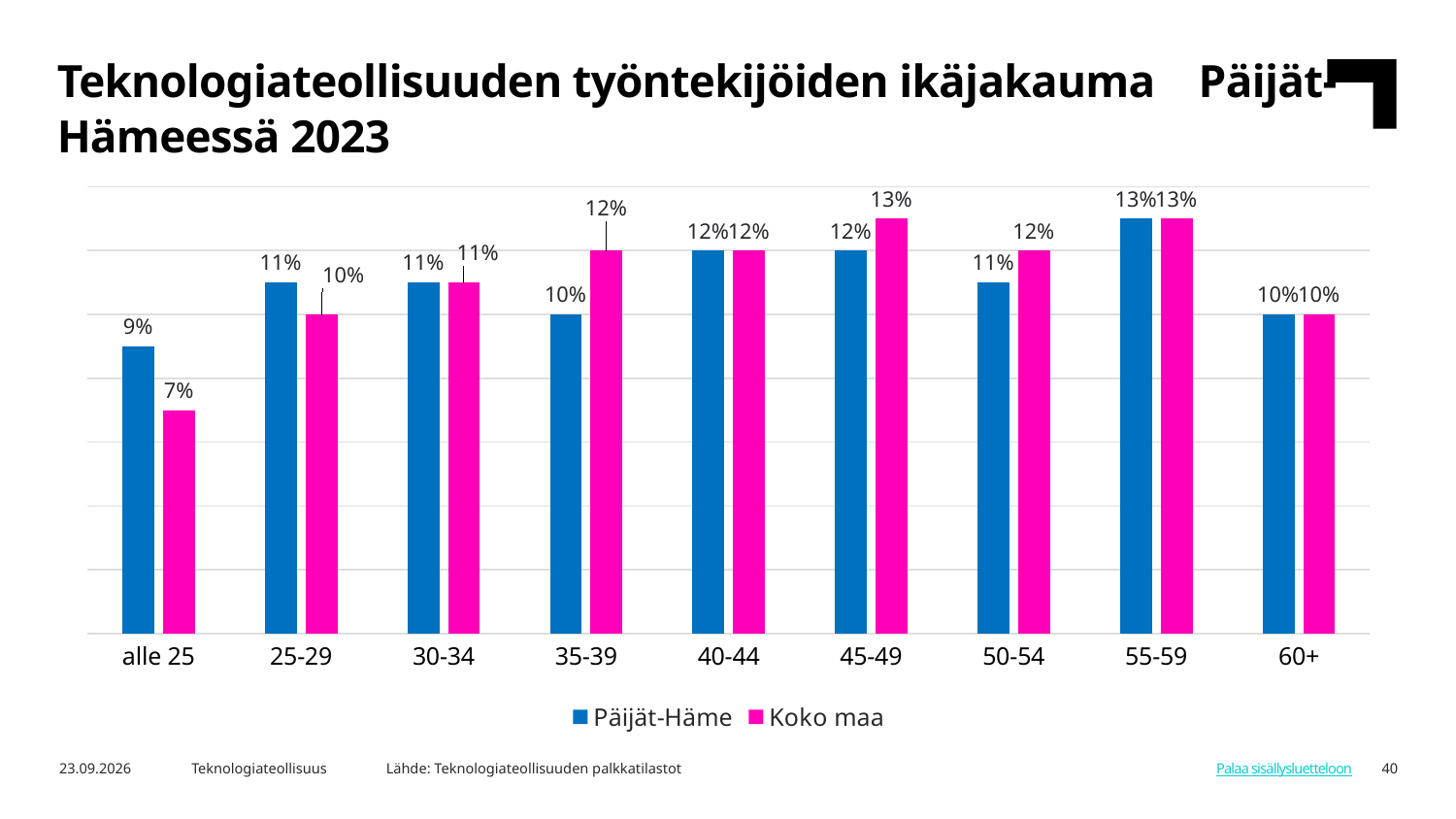
Which series is shown in pink in the legend? Koko maa Which age category has the lowest value for Koko maa? alle 25 What is the value for Koko maa in the 'alle 25' category? 7% How many age categories are shown on the x axis? 9 What is the value for Koko maa in the 35-39 category? 12% What is the difference between the Päijät-Häme and Koko maa values in the 'alle 25' category? 2% What kind of chart is shown on the slide? bar chart What is the value for Päijät-Häme in the 'alle 25' category? 9% In the 35-39 category, which is larger: Päijät-Häme or Koko maa? Koko maa Which age category has the lowest value for Päijät-Häme? alle 25 Which age category has the highest value for Päijät-Häme? 55-59 How many series does the legend list? 2